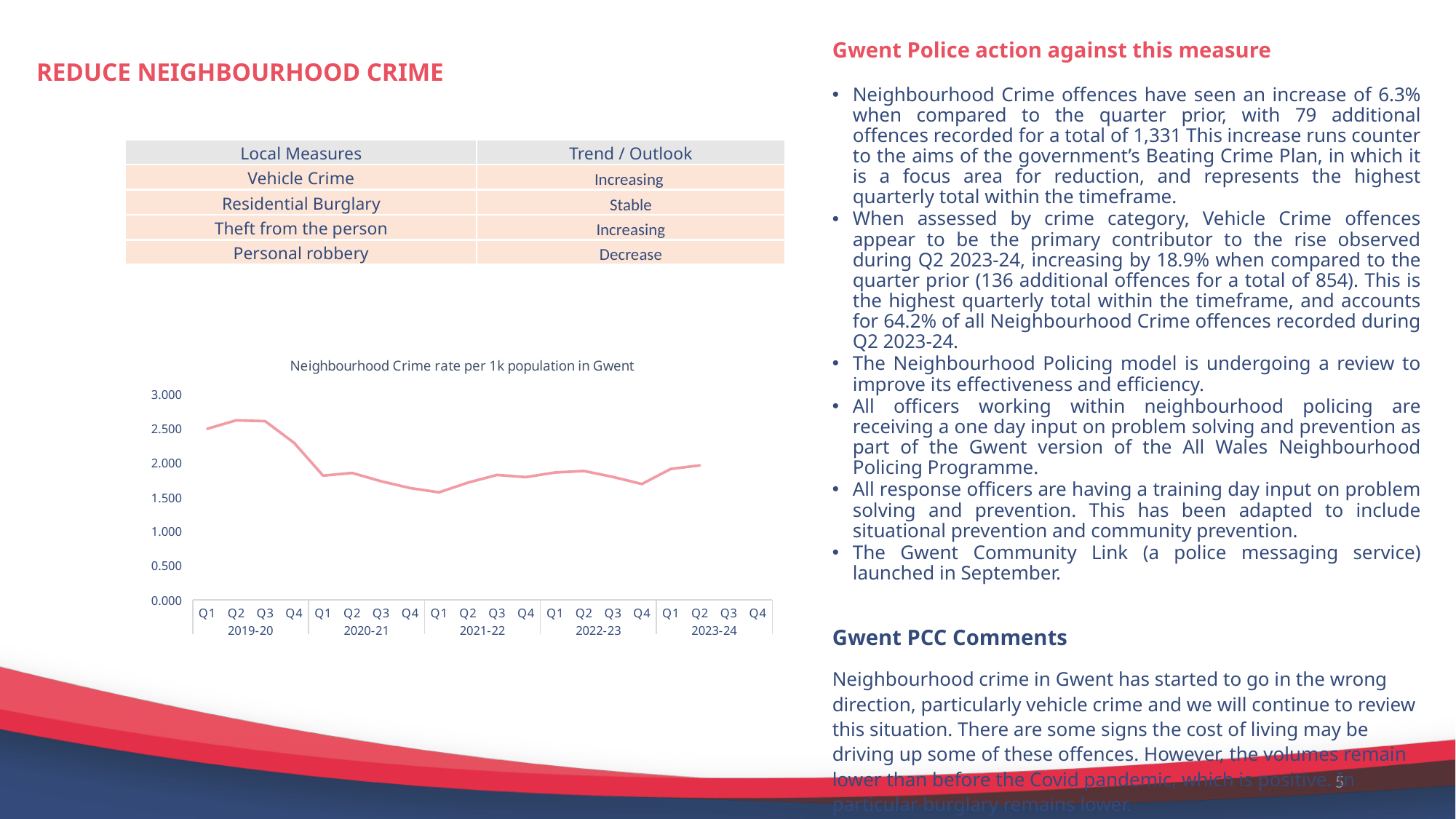
How many financial years are labelled on the x axis of the chart? 5 What kind of chart is shown on the slide? Line chart Is the value for Q2 2019-20 greater or less than 2.000? greater Which is larger, the value for Q1 2019-20 or the value for Q1 2020-21? Q1 2019-20 What is the title of the chart? Neighbourhood Crime rate per 1k population in Gwent Which is larger, the value for Q1 2021-22 or the value for Q2 2023-24? Q2 2023-24 Is the value for Q3 2019-20 greater or less than 2.000? greater Is the value for Q1 2020-21 greater or less than 2.000? less Does the crime rate rise or fall between Q3 2019-20 and Q1 2020-21? Fall Does the crime rate rise or fall between Q4 2022-23 and Q2 2023-24? Rise